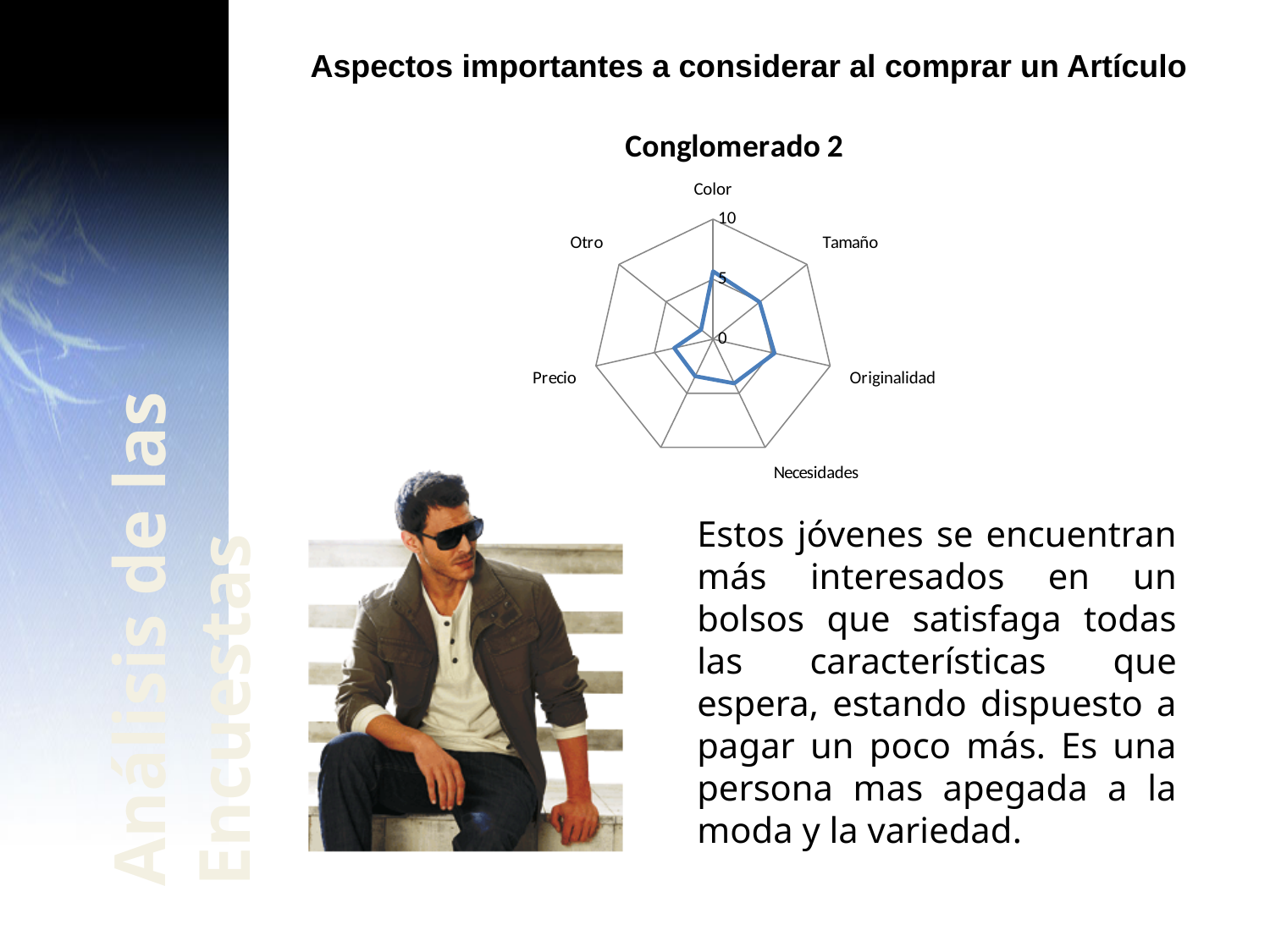
Which is larger, the value for Color or the value for Otro? Color How many data series are plotted on the chart? 1 Which is larger, the value for Tamaño or the value for Otro? Tamaño Is the value for Otro greater or less than 5? less What is the highest value shown on the chart's axis scale? 10 What is the title of the chart? Conglomerado 2 Is the value for Precio greater or less than 5? less Which category has the lowest value on the chart? Otro Is the value for Tamaño greater or less than 10? less What kind of chart is shown on the slide? radar chart Which is larger, the value for Originalidad or the value for Precio? Originalidad